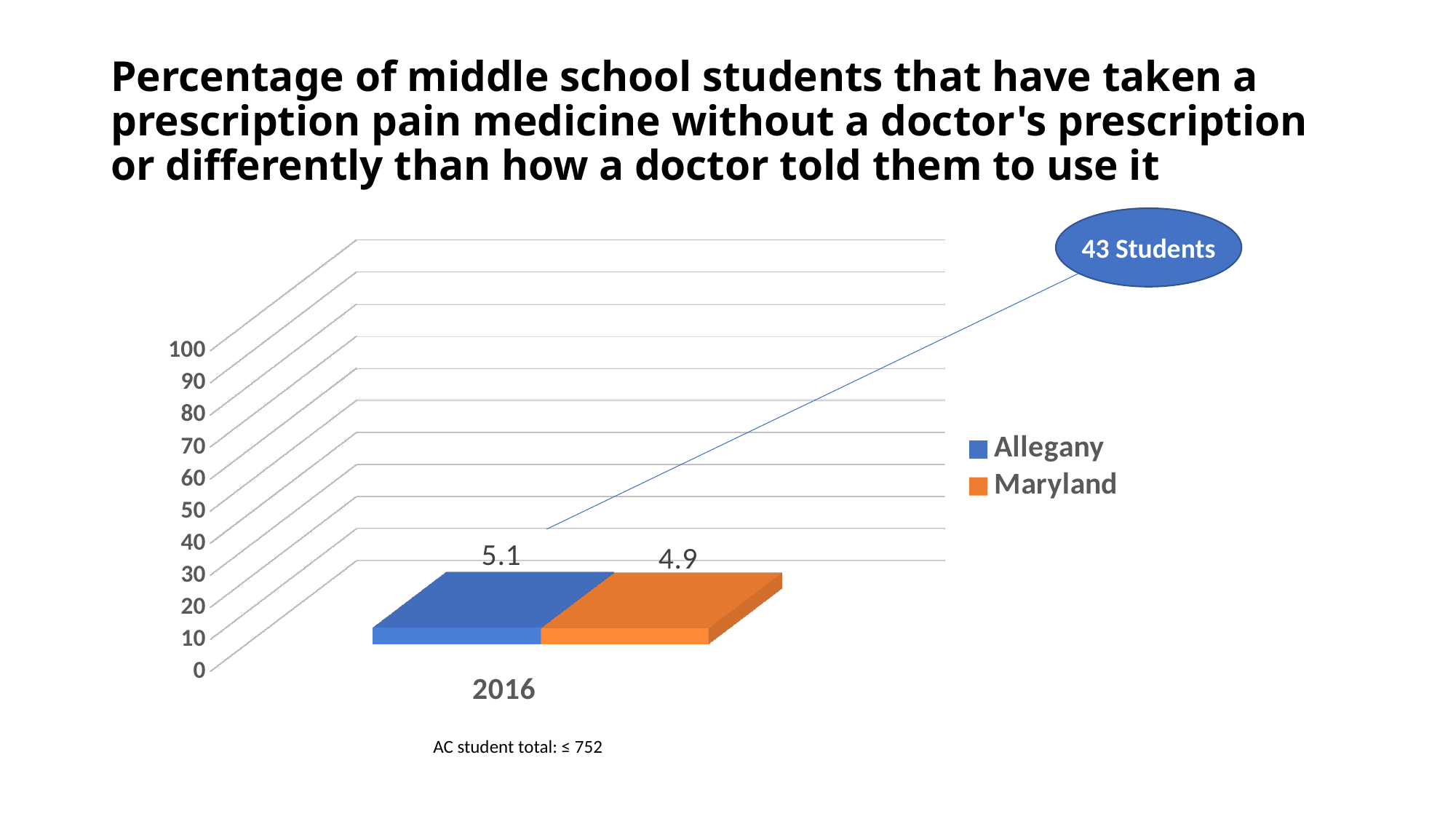
What is the difference between the Allegany and Maryland values in 2016? 0.2 What is the value for Allegany in 2016? 5.1 Is the value for Maryland in 2016 greater or less than 10? less Which year is shown on the x axis of the chart? 2016 What is the highest value shown on the vertical axis? 100 Which series has the higher value in 2016, Allegany or Maryland? Allegany How many categories are shown on the x axis? 1 What kind of chart is shown on the slide? bar chart Is the value for Allegany in 2016 greater or less than 10? less What does the callout bubble on the chart say? 43 Students How many series does the legend list? 2 What is the value for Maryland in 2016? 4.9